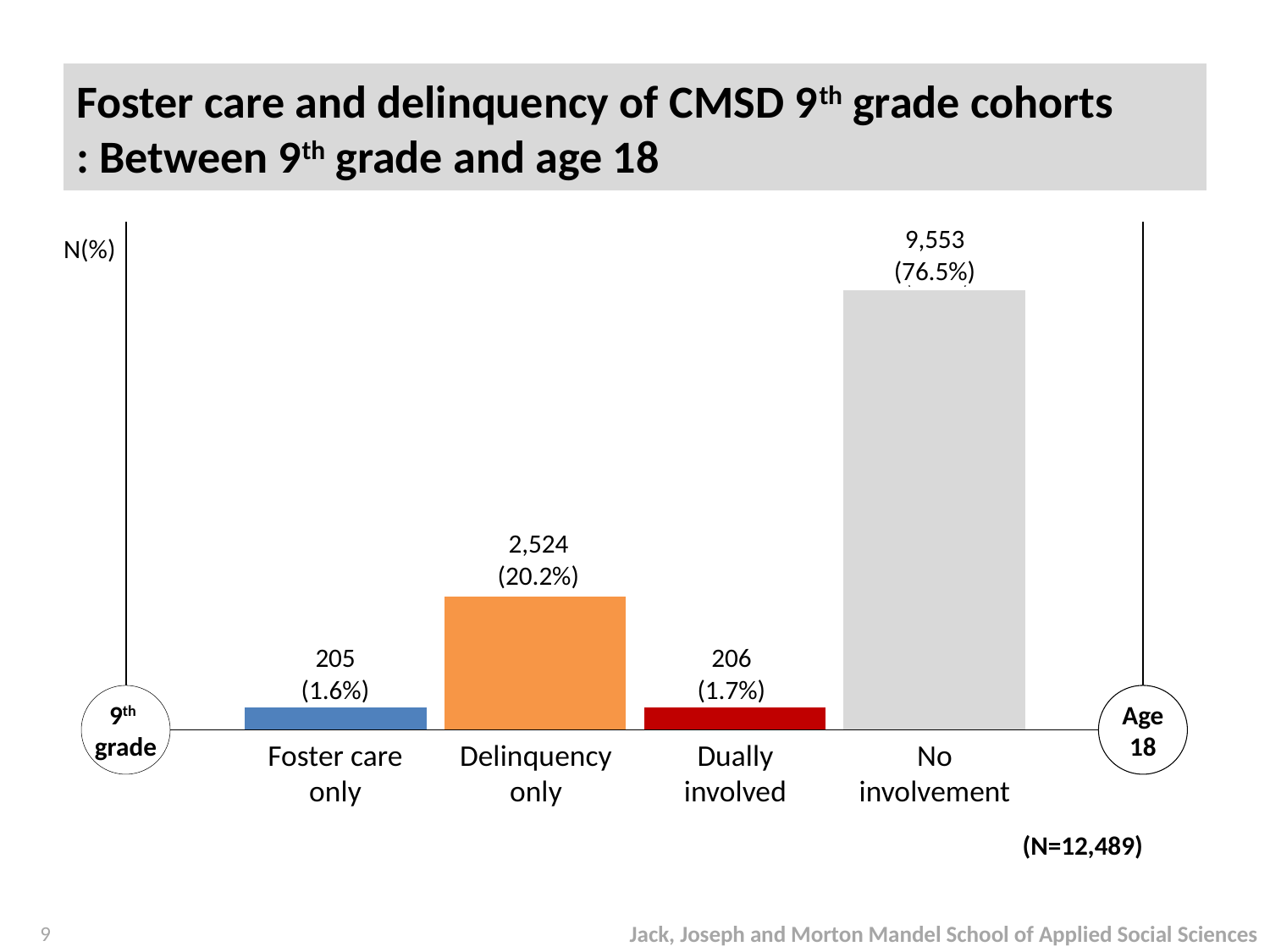
What total N is stated below the chart? N=12,489 What is the count for the Delinquency only category? 2,524 Which has a larger count, Delinquency only or Dually involved? Delinquency only What is the difference in count between Dually involved and Foster care only? 1 What is the count for the Foster care only category? 205 Which category has the lowest count? Foster care only What percentage is shown for the Dually involved category? 1.7% What is the difference in count between No involvement and Delinquency only? 7,029 How many categories are shown in the chart? 4 What kind of chart is shown on the slide? Bar chart Which category has the highest count? No involvement What percentage is shown for the No involvement category? 76.5%